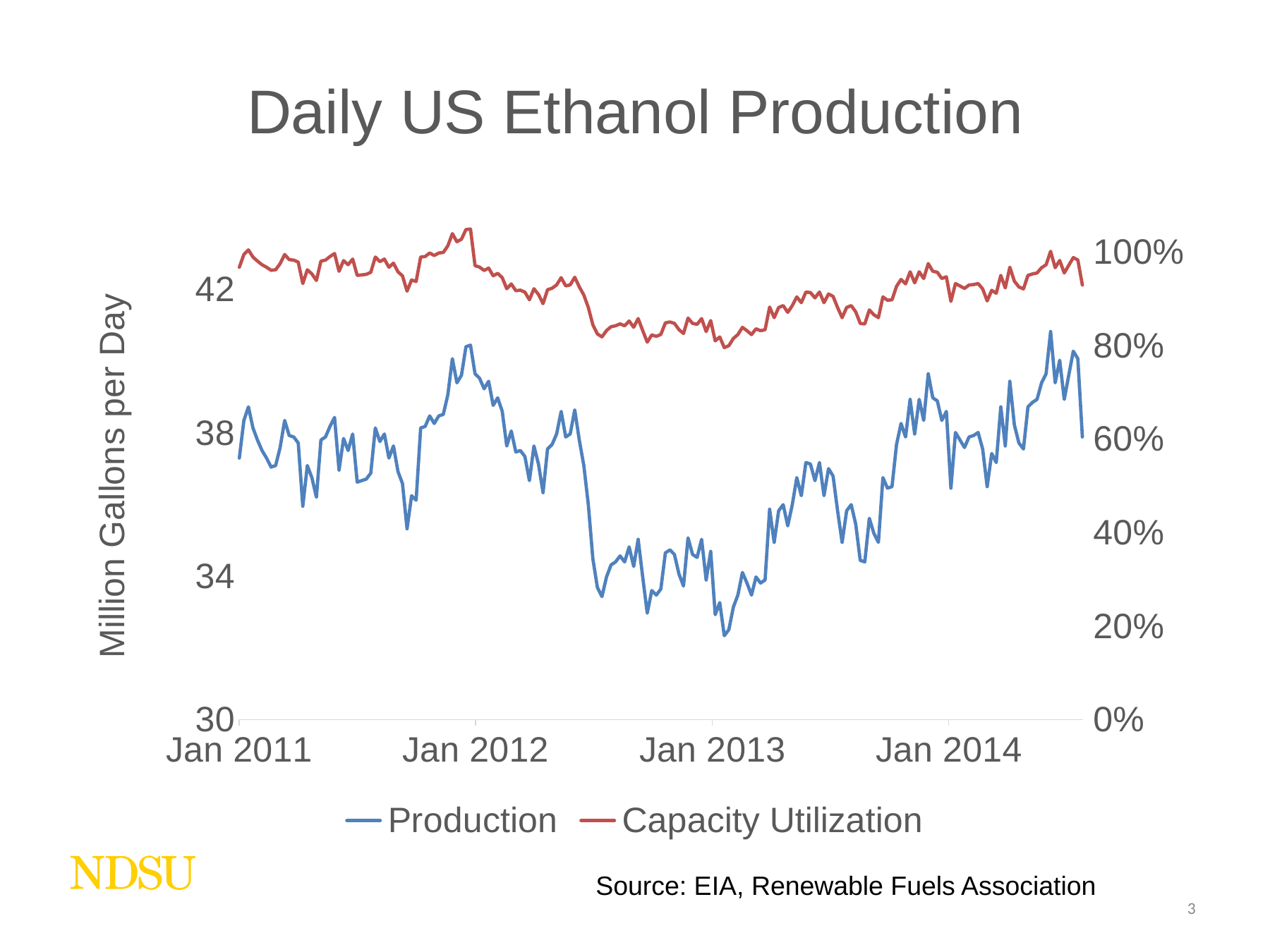
What is the label on the left vertical axis? Million Gallons per Day How many series does the legend list? 2 Is the Capacity Utilization value at Jan 2013 greater or less than 100%? less Is the Production value at Jan 2012 greater or less than 38? greater Does Capacity Utilization rise or fall between Jan 2012 and Jan 2013? fall What kind of chart is shown on the slide? Line chart Is the Capacity Utilization value at Jan 2014 greater or less than 80%? greater What is the title of the chart? Daily US Ethanol Production Does Production rise or fall between Jan 2012 and Jan 2013? fall Does Production rise or fall between Jan 2013 and Jan 2014? rise Is the lowest point of the Production line closer to Jan 2012 or Jan 2013? Jan 2013